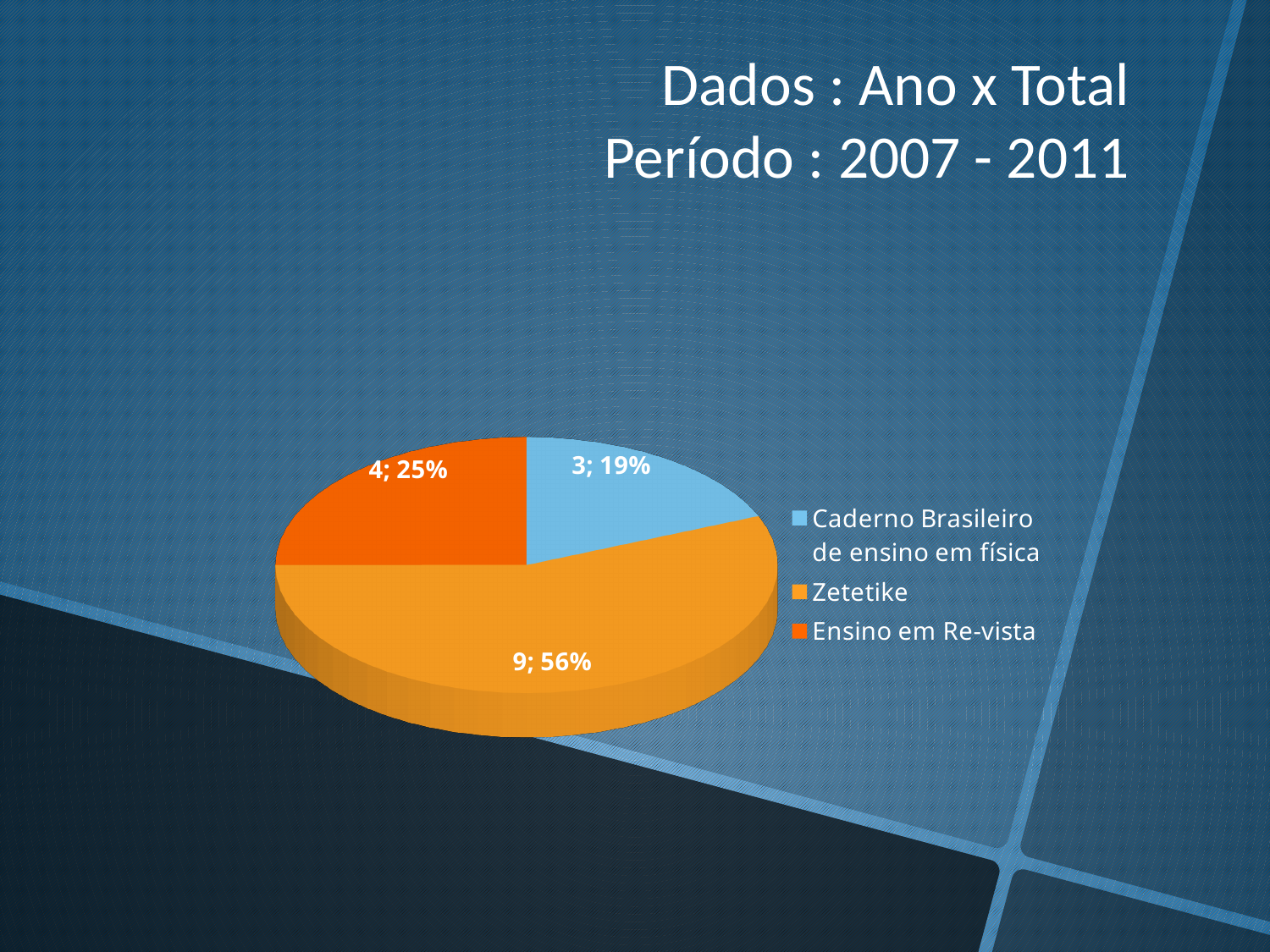
Which category has the largest slice? Zetetike Which category has the smallest slice? Caderno Brasileiro de ensino em física What is the total of all the slice values in the pie chart? 16 What share of the pie does Ensino em Re-vista represent? 25% What is the value for Zetetike? 9 What is the value for Ensino em Re-vista? 4 What share of the pie does Zetetike represent? 56% What kind of chart is shown on the slide? pie chart What is the value for Caderno Brasileiro de ensino em física? 3 What is the difference between the values for Zetetike and Ensino em Re-vista? 5 How many slices does the pie chart have? 3 What share of the pie does Caderno Brasileiro de ensino em física represent? 19%